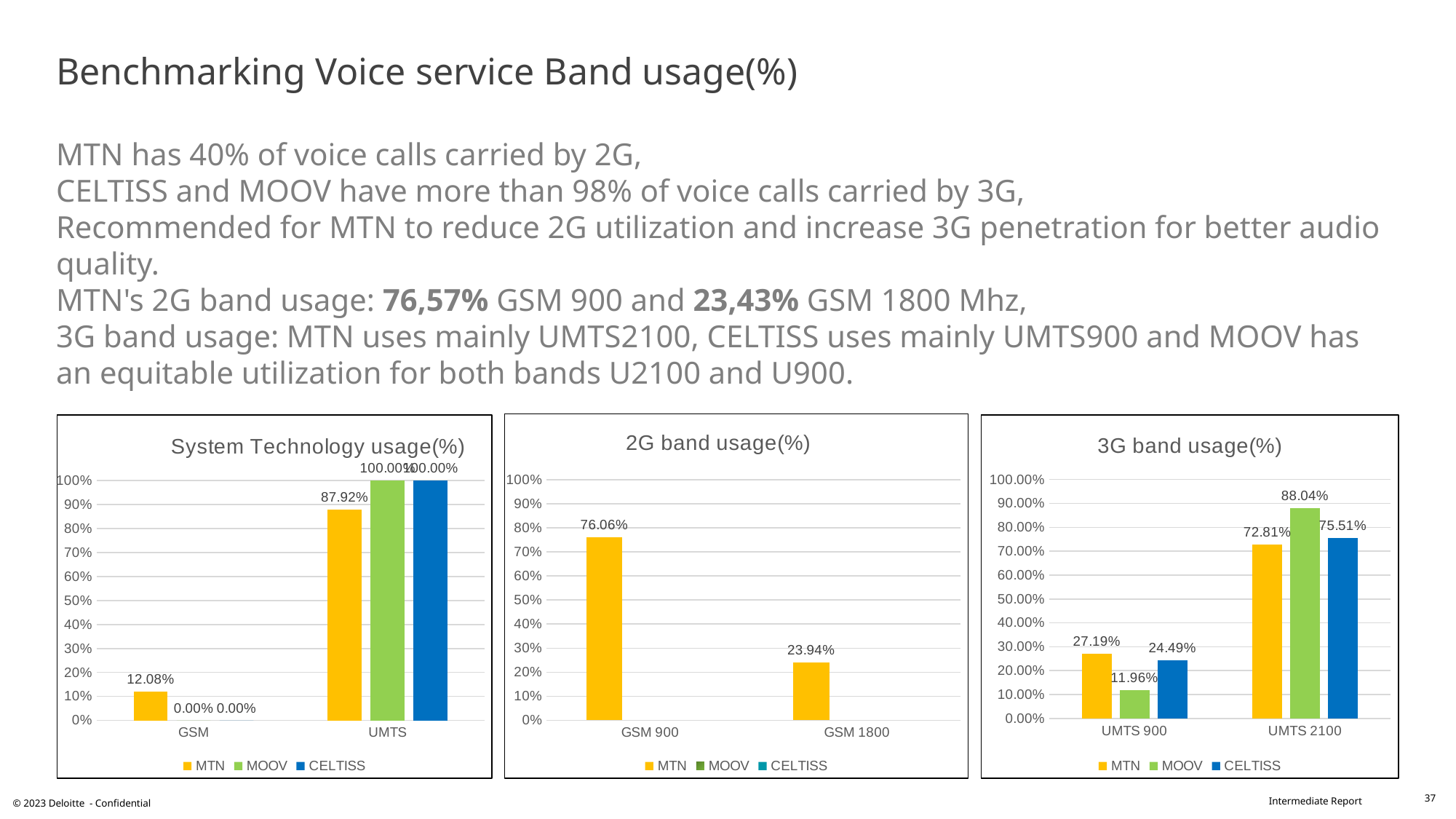
In the 'System Technology usage(%)' chart, what is the value for MTN under UMTS? 87.92% In the 'System Technology usage(%)' chart, what is the value for MOOV under UMTS? 100.00% In the '2G band usage(%)' chart, what is the difference between the MTN values for GSM 900 and GSM 1800? 52.12% What kind of chart is the '2G band usage(%)' chart? Bar chart In the '3G band usage(%)' chart, which operator has the lowest value under UMTS 900? MOOV In the '3G band usage(%)' chart, what is the difference between the CELTISS values for UMTS 2100 and UMTS 900? 51.02% In the '3G band usage(%)' chart, which operator has the highest value under UMTS 2100? MOOV In the '3G band usage(%)' chart, which is larger under UMTS 900: MTN or CELTISS? MTN How many series does the legend of the '3G band usage(%)' chart list? 3 In the '3G band usage(%)' chart, what is the value for MOOV under UMTS 2100? 88.04% In the 'System Technology usage(%)' chart, what is the value for MTN under GSM? 12.08% In the '2G band usage(%)' chart, what is the value for MTN under GSM 900? 76.06%